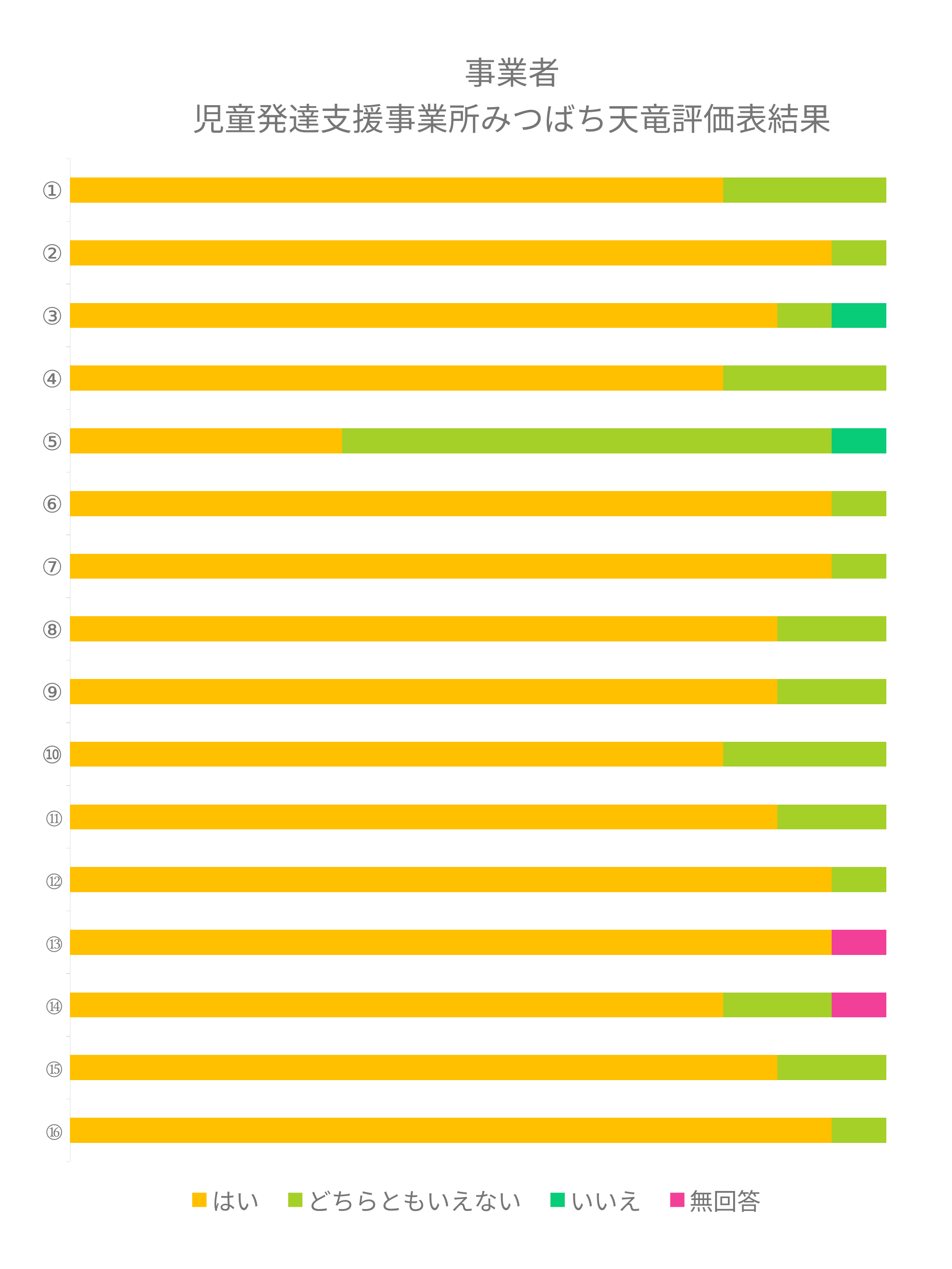
Is the どちらともいえない segment larger for ① or for ②? ① Is the はい segment larger for ④ or for ⑤? ④ Which category has the smallest はい segment? ⑤ Which category has the largest どちらともいえない segment? ⑤ Which series is shown in yellow? はい Which categories include a 無回答 segment? ⑬ and ⑭ Which categories include an いいえ segment? ③ and ⑤ How many series does the legend list? 4 What kind of chart is shown on the slide? Stacked bar chart Is the はい segment larger for ⑤ or for ⑩? ⑩ How many categories (numbered items) are plotted on the chart? 16